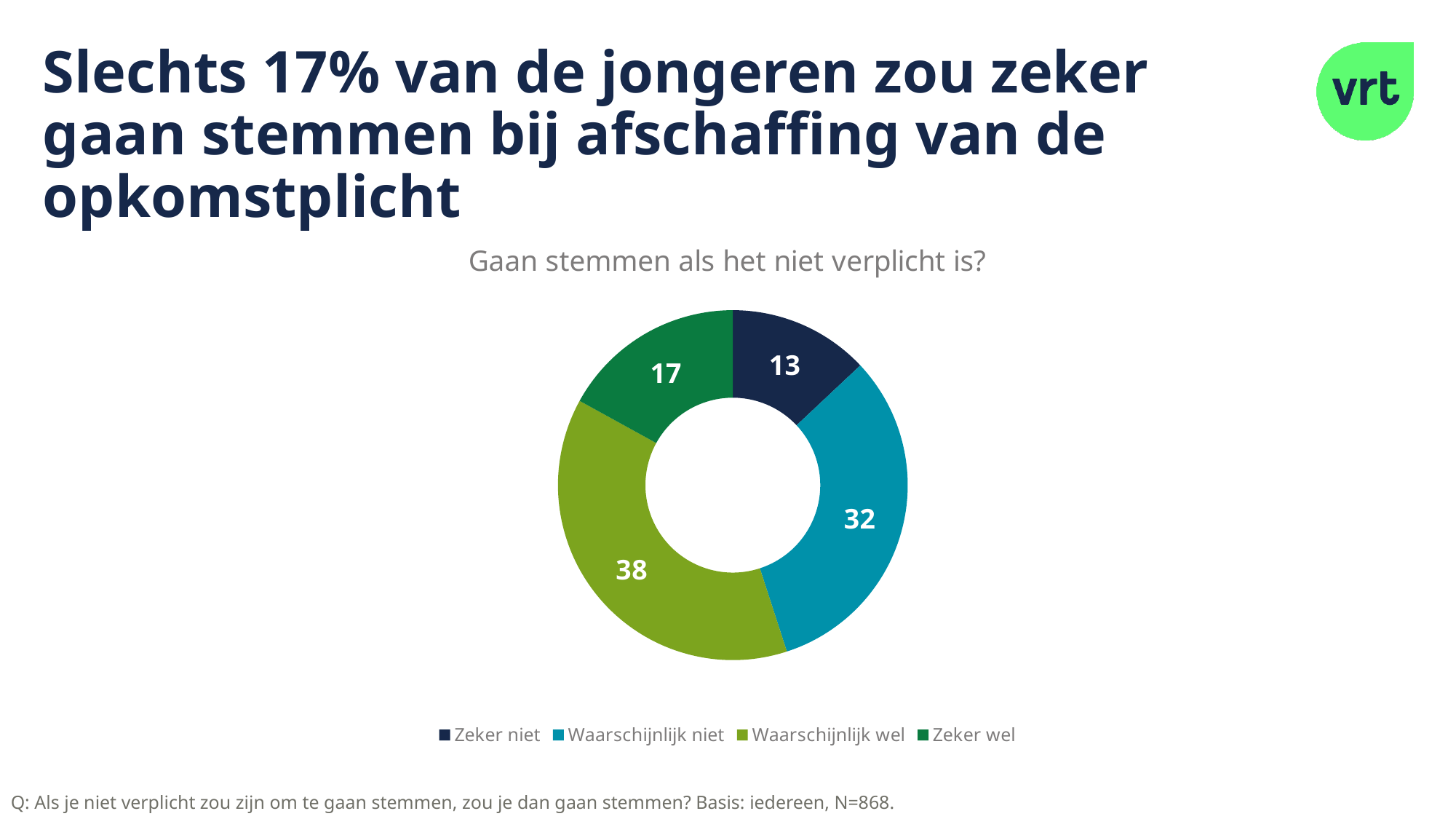
What kind of chart is shown on the slide? Doughnut chart What is the difference between the values for "Waarschijnlijk wel" and "Waarschijnlijk niet"? 6 What is the title of the chart? Gaan stemmen als het niet verplicht is? What is the value for "Zeker niet"? 13 Which is larger, the value for "Zeker wel" or the value for "Zeker niet"? Zeker wel Which category has the highest value? Waarschijnlijk wel What is the value for "Zeker wel"? 17 What is the value for "Waarschijnlijk niet"? 32 What is the total of the values for "Zeker niet" and "Waarschijnlijk niet"? 45 What is the value for "Waarschijnlijk wel"? 38 How many categories does the chart show? 4 Which category has the lowest value? Zeker niet